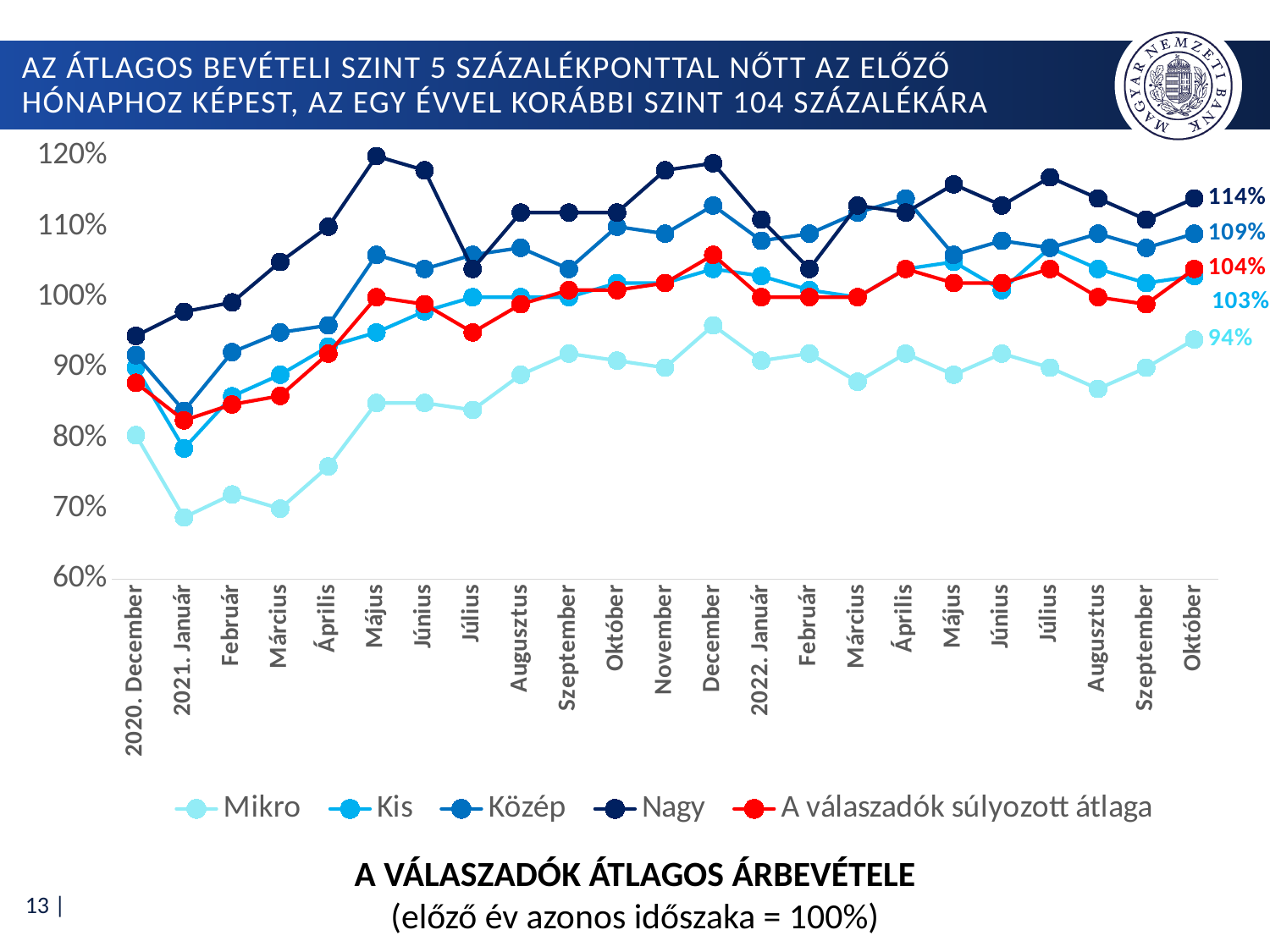
Which is larger in Május 2021, the Nagy value or the Mikro value? Nagy What is the value of the Közép series at Október 2022? 109% What is the value of 'A válaszadók súlyozott átlaga' at Október 2022? 104% Which series has the lowest value at Október 2022? Mikro How many series does the legend list? 5 What is the value of the Nagy series at Október 2022, the last point on the chart? 114% What is the value of the Mikro series at Október 2022? 94% What kind of chart is shown on the slide? Line chart Which series has the highest value at Október 2022? Nagy What is the difference between the Nagy and Mikro values at Október 2022? 20 percentage points Is the value of the Nagy series in Május 2021 greater or less than 110%? greater How many months are plotted along the x axis? 23